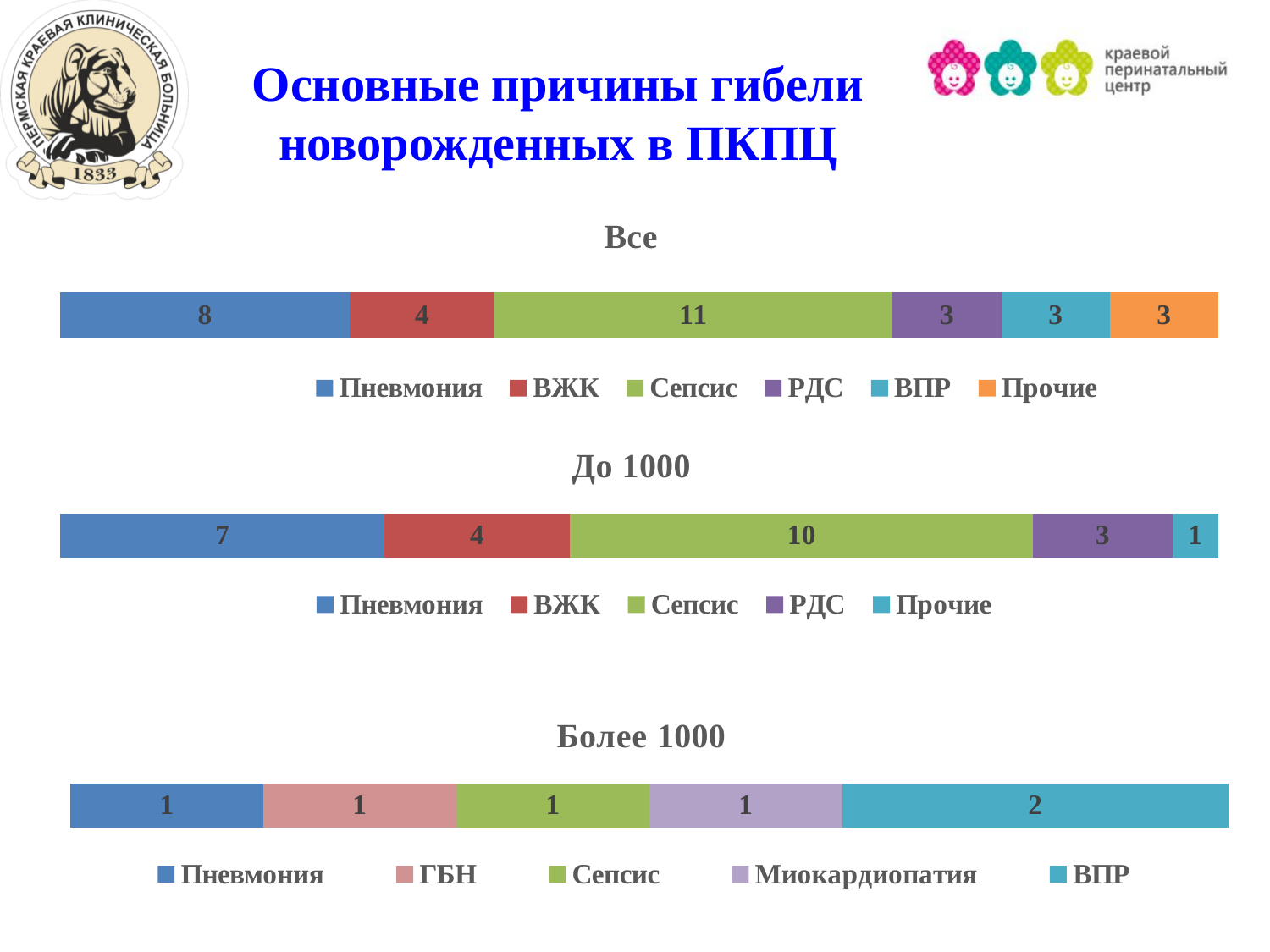
In the "До 1000" chart, what is the value for Пневмония? 7 In the "Более 1000" chart, how many series does the legend list? 5 In the "Более 1000" chart, which cause has the highest value? ВПР In the "Все" chart, how many series does the legend list? 6 In the "Все" chart, what is the total of the stacked bar? 32 In the "Более 1000" chart, what is the value for ВПР? 2 In the "До 1000" chart, what is the total of the stacked bar? 25 In the "До 1000" chart, which cause has the lowest value? Прочие What type of chart is used for the "Все" chart? Stacked bar chart In the "До 1000" chart, what is the difference between Сепсис and ВЖК? 6 In the "Все" chart, what is the value for Сепсис? 11 In the "Все" chart, which cause has the highest value? Сепсис